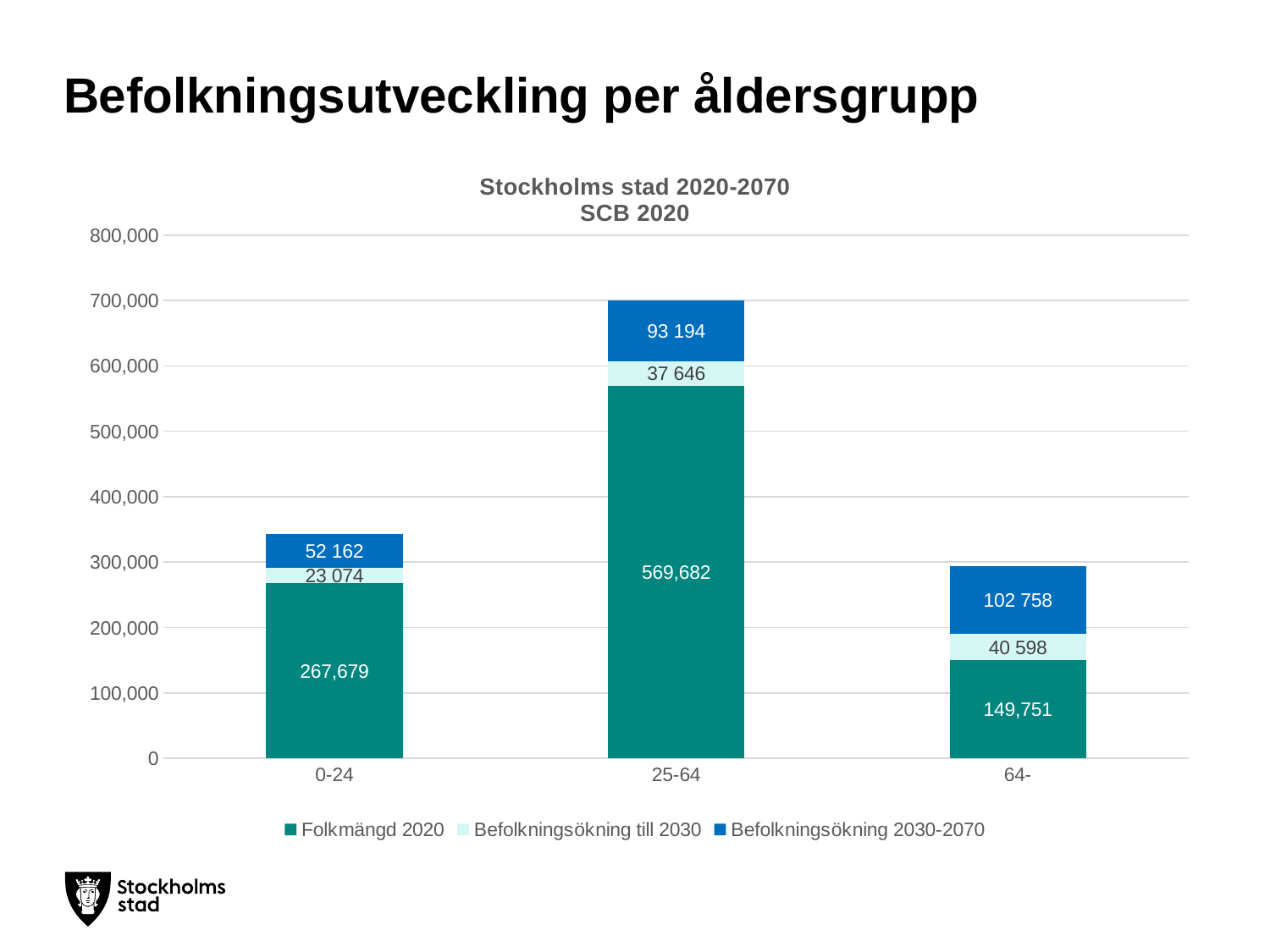
What is the Folkmängd 2020 value for the 25-64 age group? 569,682 Which age group has the lowest Befolkningsökning till 2030 value? 0-24 How many series does the legend list? 3 What kind of chart is shown on the slide? Stacked bar chart What is the difference between the Befolkningsökning 2030-2070 values for the 64- and 0-24 age groups? 50 596 What is the Befolkningsökning till 2030 value for the 0-24 age group? 23 074 What is the total of the stacked bar for the 25-64 age group? 700,522 Which is larger: the Folkmängd 2020 value for 0-24 or for 64-? 0-24 What is the subtitle of the chart? Stockholms stad 2020-2070 SCB 2020 Which age group has the highest Folkmängd 2020 value? 25-64 How many age groups are shown on the x axis? 3 What is the Befolkningsökning 2030-2070 value for the 64- age group? 102 758